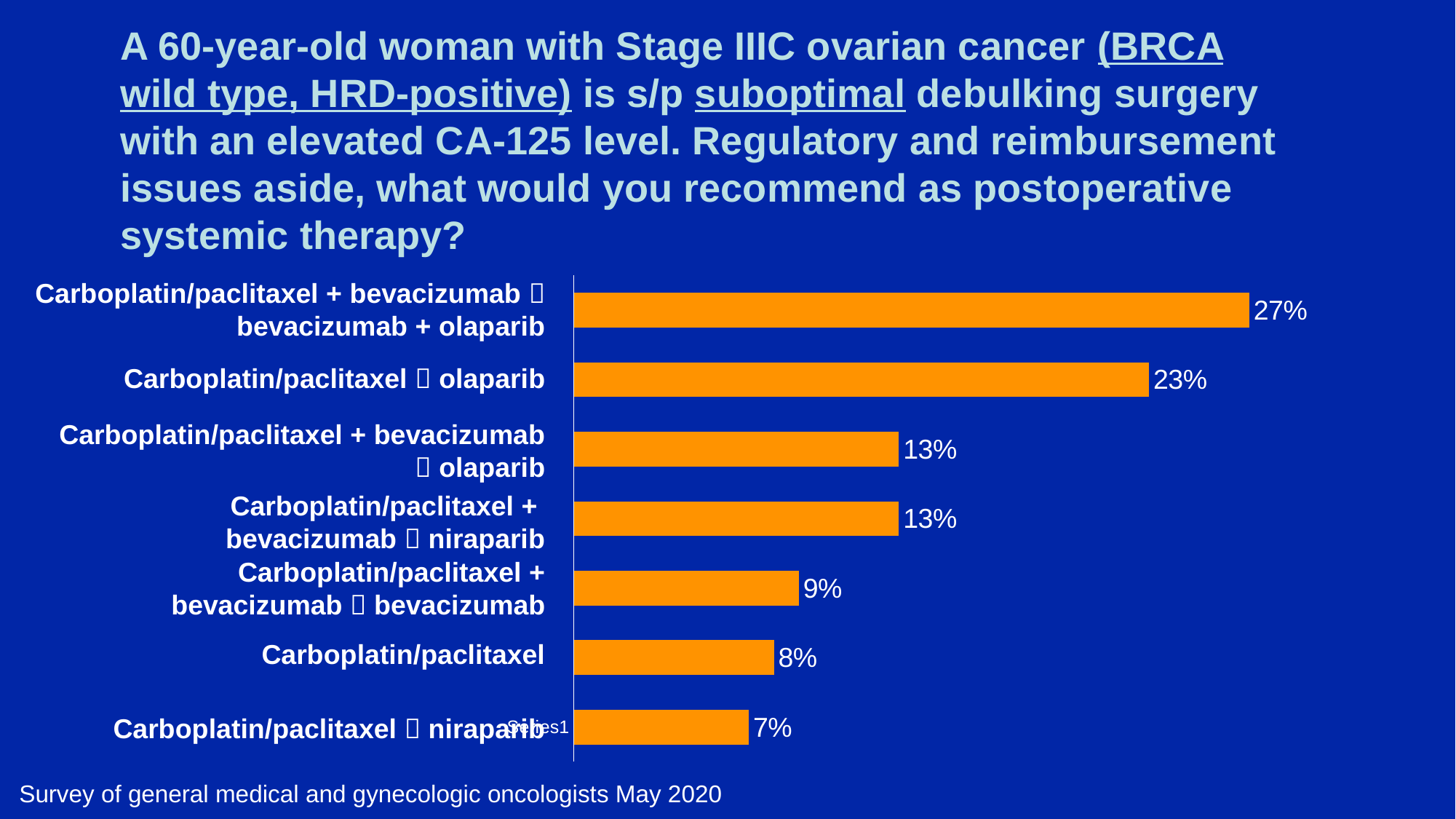
What kind of chart is shown on the slide? Bar chart What is the value for carboplatin/paclitaxel alone? 8% What percentage of respondents chose carboplatin/paclitaxel + bevacizumab → bevacizumab + olaparib? 27% How many treatment options (bars) are shown in the chart? 7 What is the difference in percentage points between the top bar (27%) and the second bar (23%)? 4 What percentage of respondents chose carboplatin/paclitaxel → olaparib? 23% What is the combined percentage of the two options with 13% each (carboplatin/paclitaxel + bevacizumab → olaparib and carboplatin/paclitaxel + bevacizumab → niraparib)? 26% What colour are the bars in the chart? Orange What is the value for carboplatin/paclitaxel → niraparib (the bottom bar)? 7% Which treatment option has the lowest percentage? Carboplatin/paclitaxel → niraparib Which treatment option has the highest percentage? Carboplatin/paclitaxel + bevacizumab → bevacizumab + olaparib Which is larger: the value for carboplatin/paclitaxel + bevacizumab → bevacizumab or the value for carboplatin/paclitaxel alone? Carboplatin/paclitaxel + bevacizumab → bevacizumab